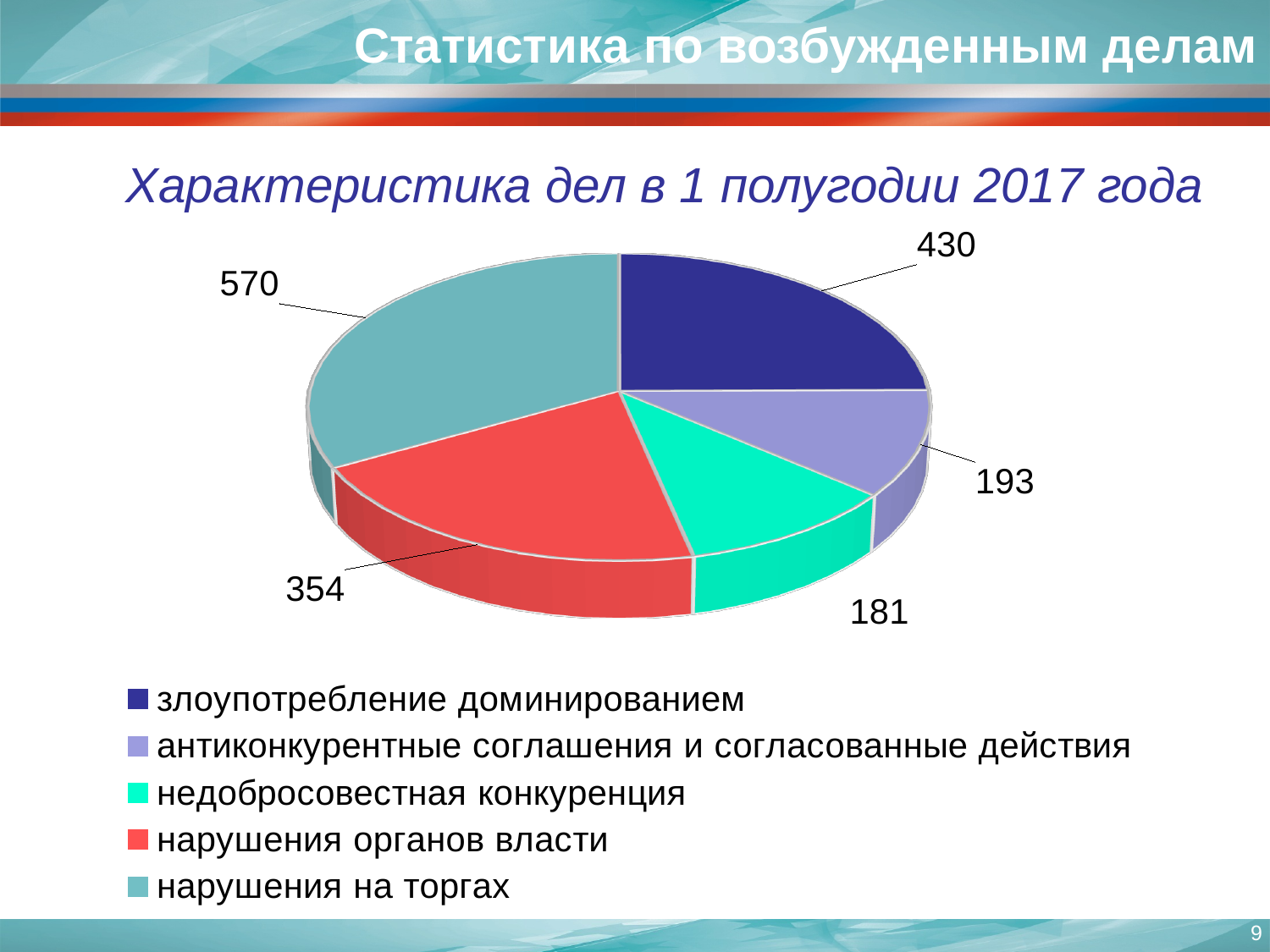
What is the value for нарушения органов власти? 354 What is the title of the chart? Характеристика дел в 1 полугодии 2017 года What is the total of all slices in the pie chart? 1728 What is the difference between the values for нарушения на торгах and злоупотребление доминированием? 140 What is the value for нарушения на торгах? 570 What is the value for злоупотребление доминированием? 430 How many categories does the pie chart have? 5 Which category has the largest slice of the pie? нарушения на торгах What is the value for недобросовестная конкуренция? 181 Which category has the smallest slice of the pie? недобросовестная конкуренция Which is larger: антиконкурентные соглашения и согласованные действия or недобросовестная конкуренция? антиконкурентные соглашения и согласованные действия What type of chart is shown on the slide? pie chart